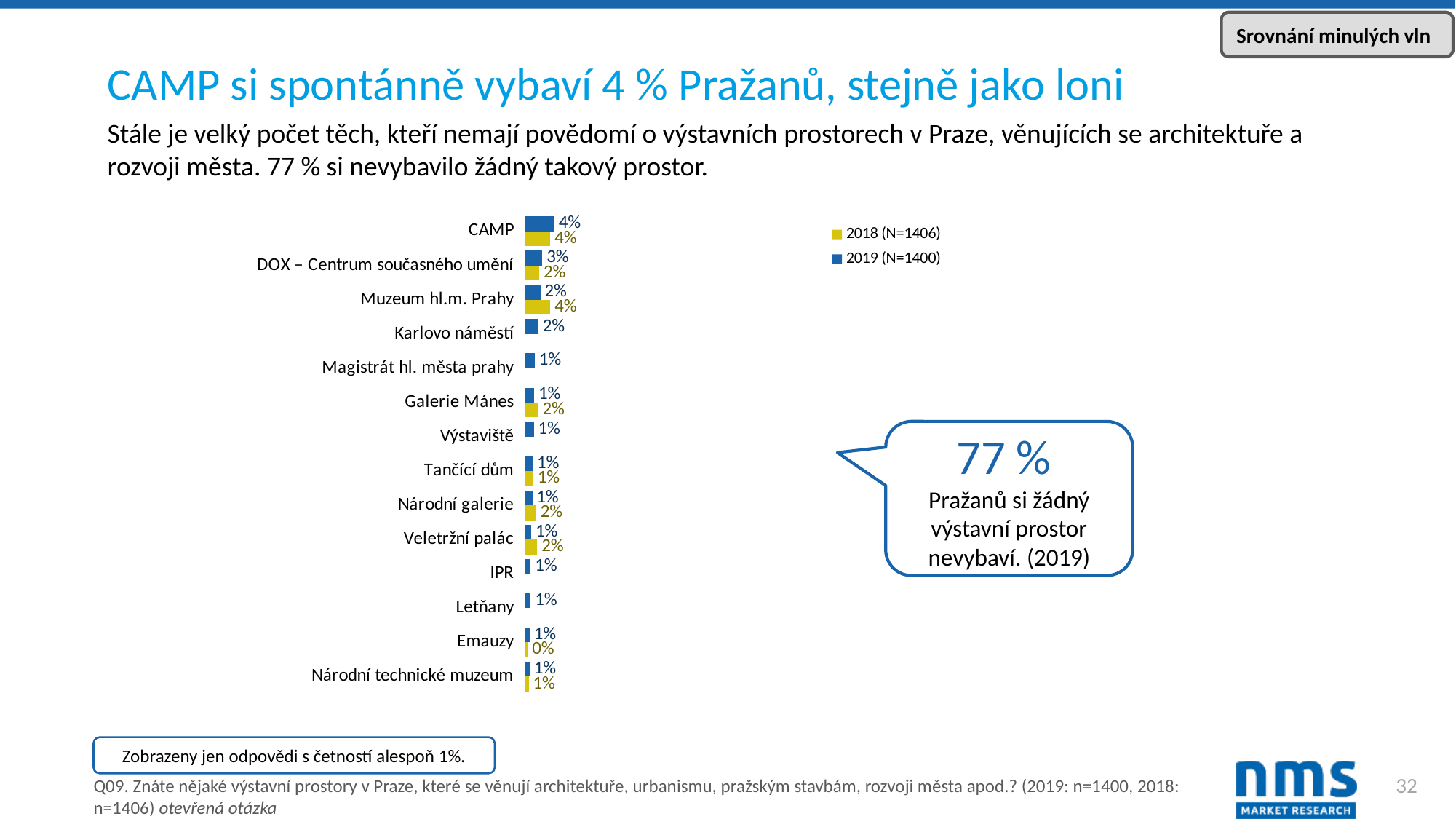
What is the difference between the 2018 and 2019 values for Muzeum hl.m. Prahy? 2% What is the 2018 value for Emauzy? 0% What is the 2018 value for Muzeum hl.m. Prahy? 4% Which category has the highest 2019 value? CAMP What is the 2019 value for CAMP? 4% How many series does the legend list? 2 Which is larger for DOX – Centrum současného umění: the 2018 value or the 2019 value? 2019 What kind of chart is shown on the slide? Bar chart What sample size is given in the legend for the 2019 series? N=1400 How many categories are shown in the chart? 14 Which category has the lowest 2018 value among those with a 2018 bar? Emauzy What is the 2019 value for DOX – Centrum současného umění? 3%